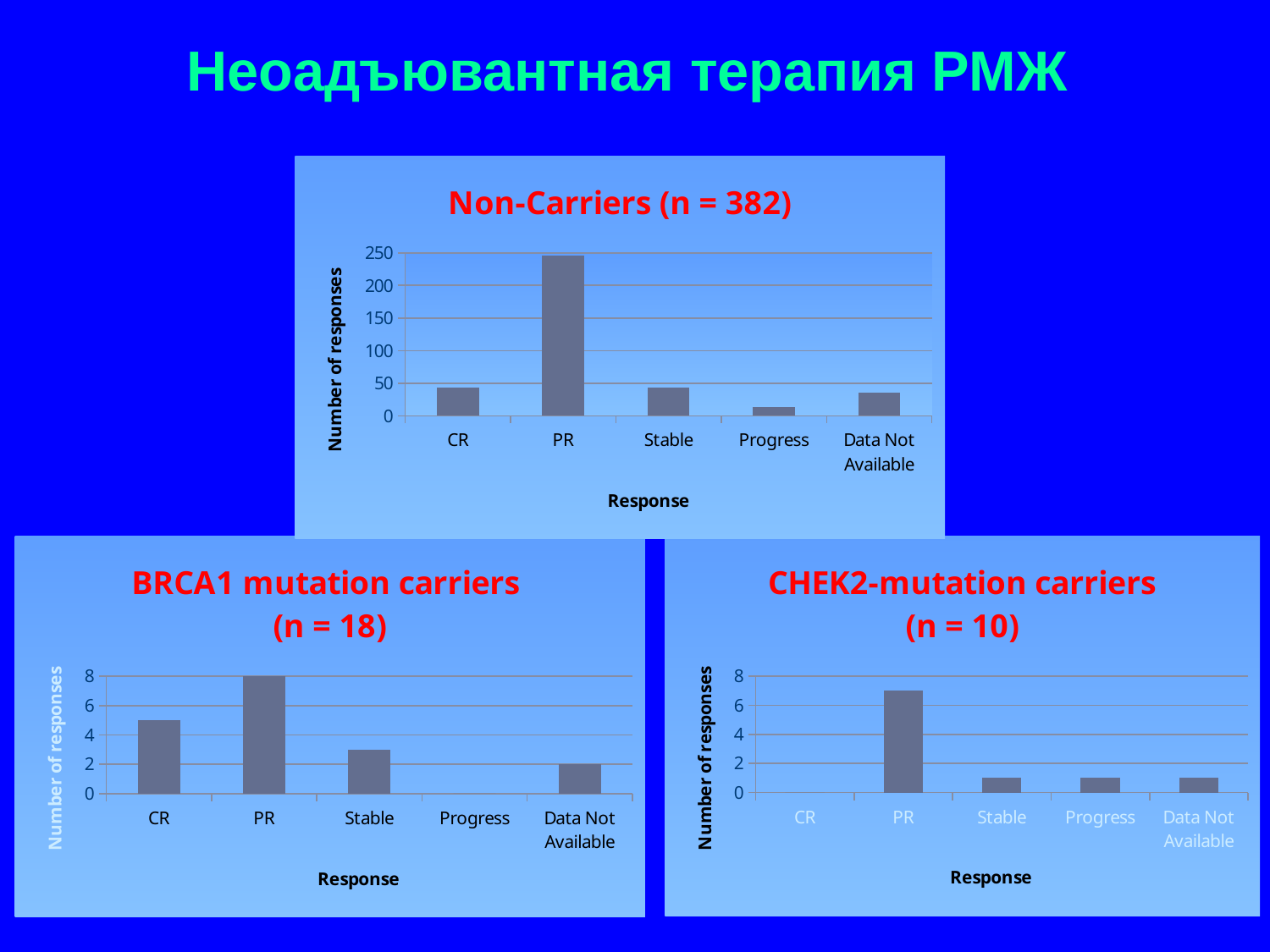
In the Non-Carriers (n = 382) chart, which response category has the highest number of responses? PR In the BRCA1 mutation carriers (n = 18) chart, what is the number of responses for Data Not Available? 2 How many response categories are shown on the x axis of the Non-Carriers (n = 382) chart? 5 In the CHEK2-mutation carriers (n = 10) chart, is the value for PR greater or less than 6? greater In the CHEK2-mutation carriers (n = 10) chart, which response category has the highest number of responses? PR In the BRCA1 mutation carriers (n = 18) chart, is the value for CR greater or less than 4? greater In the Non-Carriers (n = 382) chart, is the value for PR greater or less than 200? greater What kind of chart is the Non-Carriers (n = 382) chart? bar chart In the BRCA1 mutation carriers (n = 18) chart, what is the number of responses for PR? 8 In the Non-Carriers (n = 382) chart, which response category has the lowest number of responses? Progress In the BRCA1 mutation carriers (n = 18) chart, which is larger, the value for CR or the value for Stable? CR